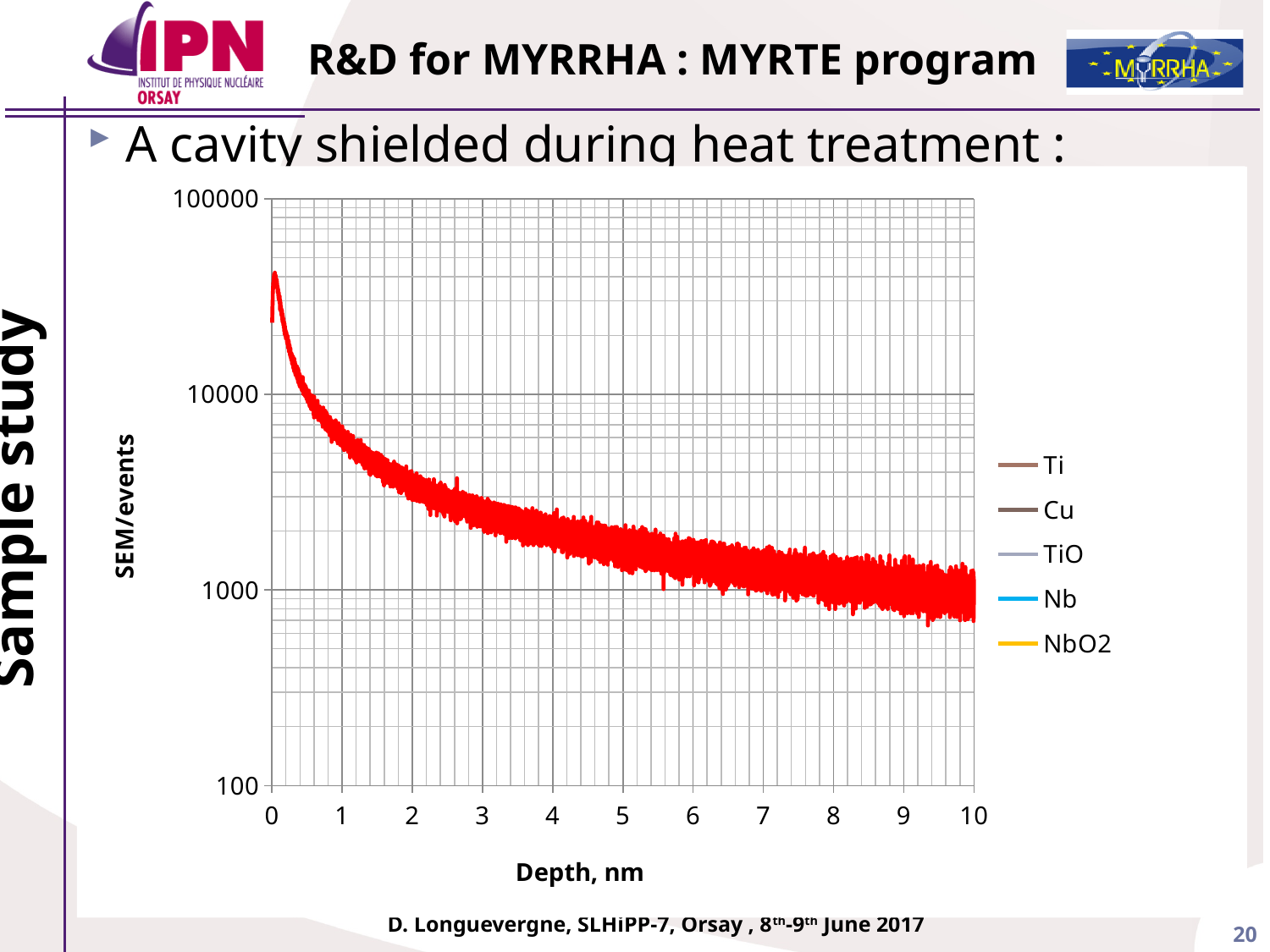
Is the plotted value at a depth of 2 nm greater or less than 1000? greater Is the plotted value near a depth of 0 nm greater or less than 10000? greater What is the label of the x axis? Depth, nm What kind of chart is shown on the slide? line chart What is the largest depth value shown on the x axis? 10 What is the highest value shown on the y axis? 100000 Is the plotted value at a depth of 5 nm greater or less than 1000? greater How many series does the legend list? 5 Do the plotted values rise or fall as depth increases along the x axis? fall